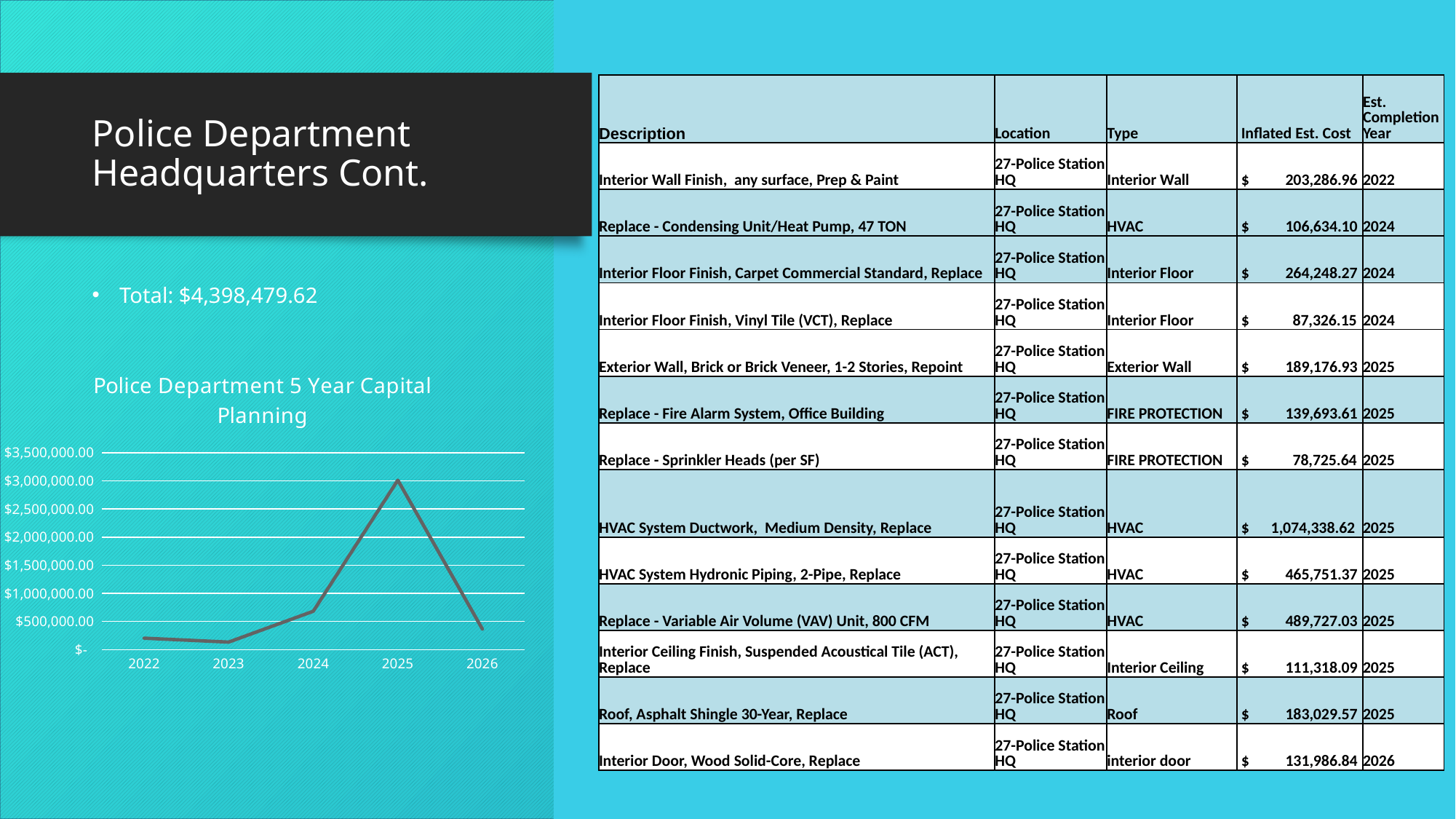
Which year has the highest value in the chart? 2025 What is the title of the chart on the slide? Police Department 5 Year Capital Planning Is the value for 2025 greater or less than $2,500,000.00? greater What is the highest tick label shown on the y axis of the chart? $3,500,000.00 Is the value for 2024 greater or less than $1,000,000.00? less Is the value for 2022 greater or less than $500,000.00? less How many years are plotted along the x axis of the chart? 5 Does the line rise or fall from 2024 to 2025? rise Which is larger, the value for 2024 or the value for 2023? 2024 What kind of chart is shown on the slide? line chart Does the line rise or fall from 2025 to 2026? fall